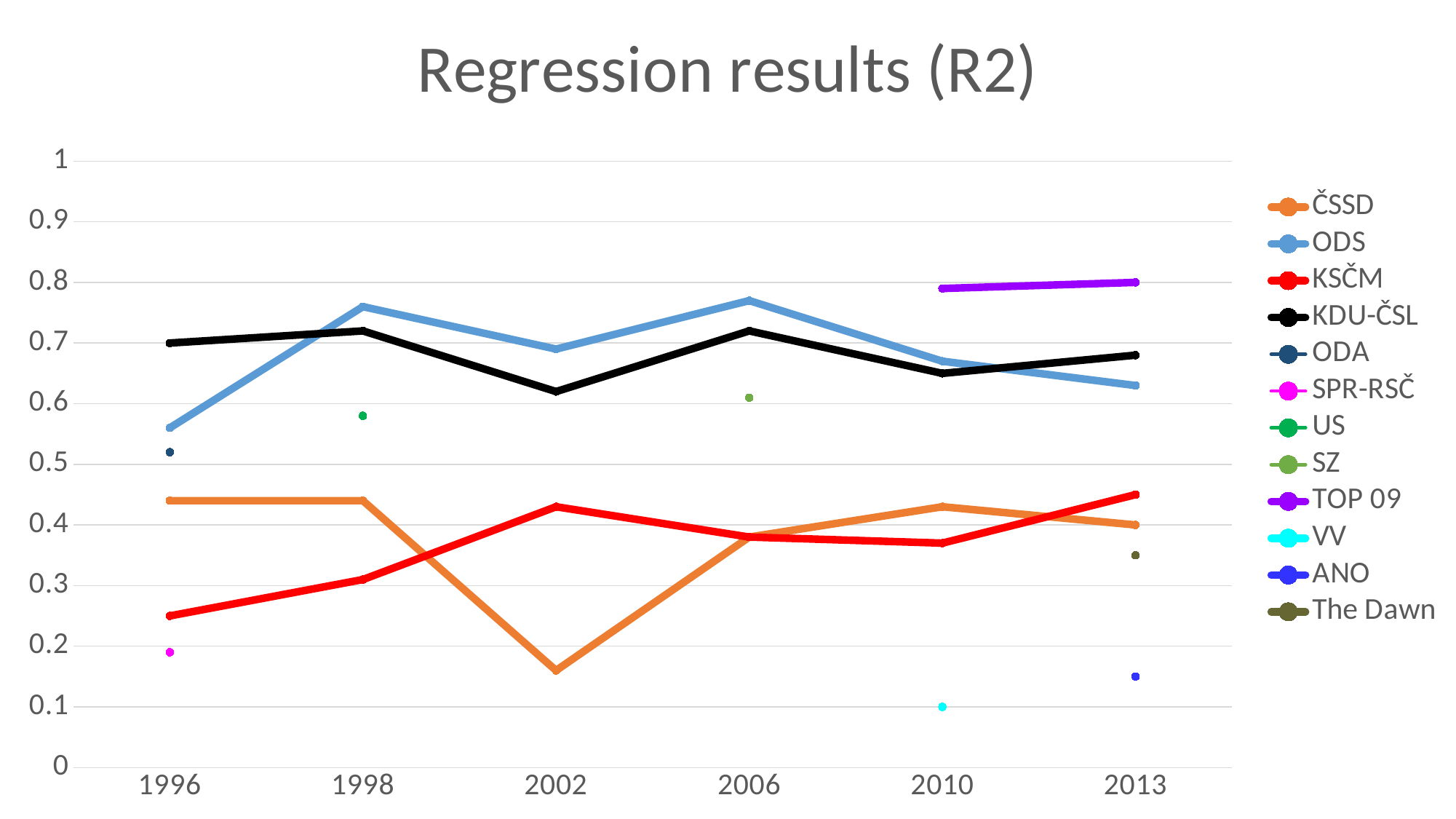
Does the KSČM line rise or fall from 1996 to 2002? rise What is the value for KDU-ČSL in 1996? 0.7 Which party has the highest value in 2013? TOP 09 What type of chart is shown on the slide? line chart How many years are shown on the x axis? 6 Is the value for ODS in 2006 greater or less than 0.7? greater Which party has the lowest value in 2010? VV In 1998, which is higher, ODS or KDU-ČSL? ODS Is the value for ČSSD in 2002 greater or less than 0.2? less How many series does the legend list? 12 What is the value for VV in 2010? 0.1 What is the title of the chart? Regression results (R2)